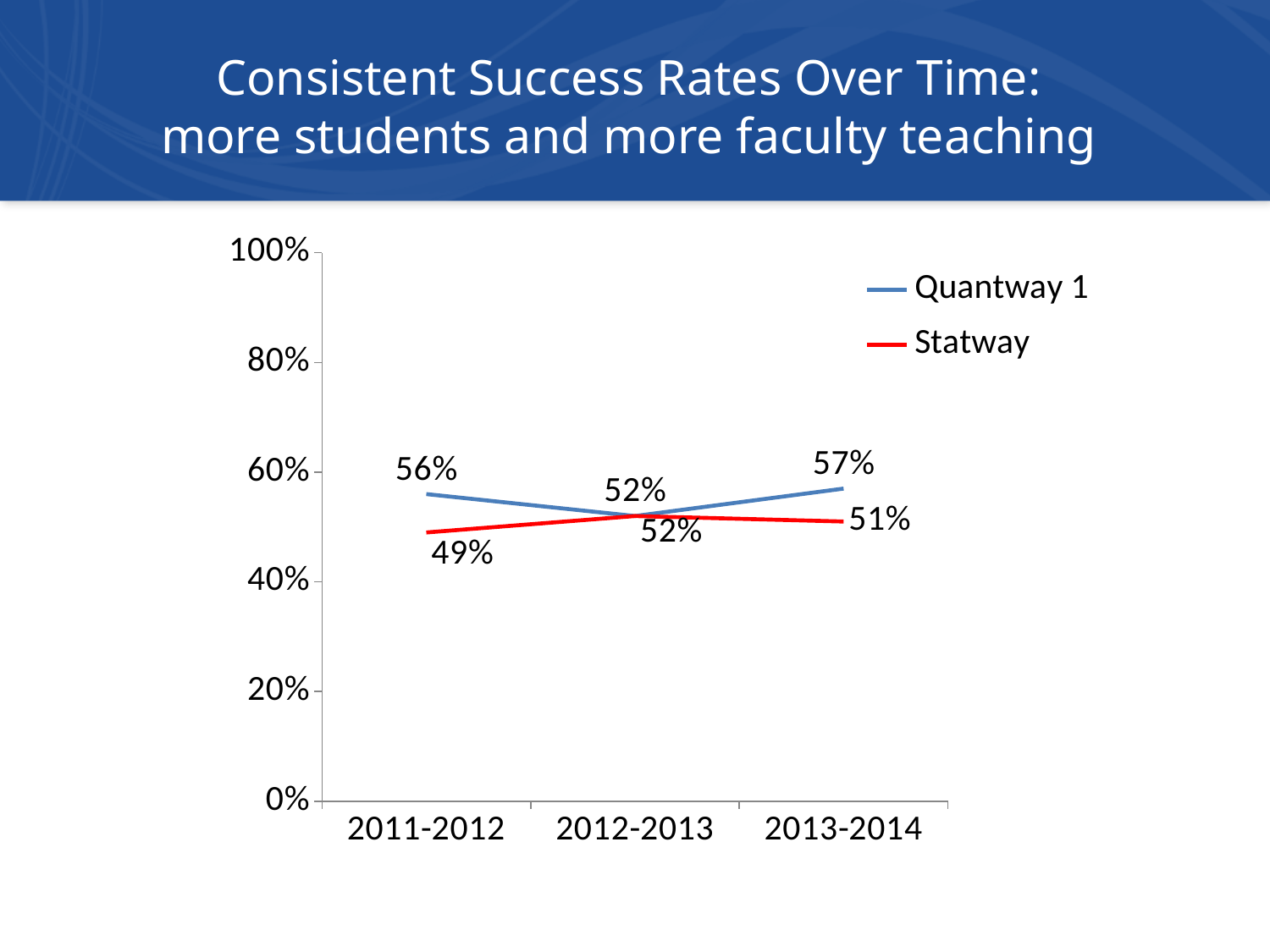
In which year was the Quantway 1 success rate highest? 2013-2014 Which series had the higher success rate in 2013-2014, Quantway 1 or Statway? Quantway 1 How many academic years are plotted on the x axis? 3 Which series is drawn in red? Statway What is the difference between the Quantway 1 and Statway success rates in 2011-2012? 7% What was the Statway success rate in 2011-2012? 49% In which year was the Statway success rate lowest? 2011-2012 What type of chart is shown on the slide? Line chart What was the Statway success rate in 2013-2014? 51% What was the Quantway 1 success rate in 2013-2014? 57% How many series does the legend list? 2 What was the Quantway 1 success rate in 2011-2012? 56%